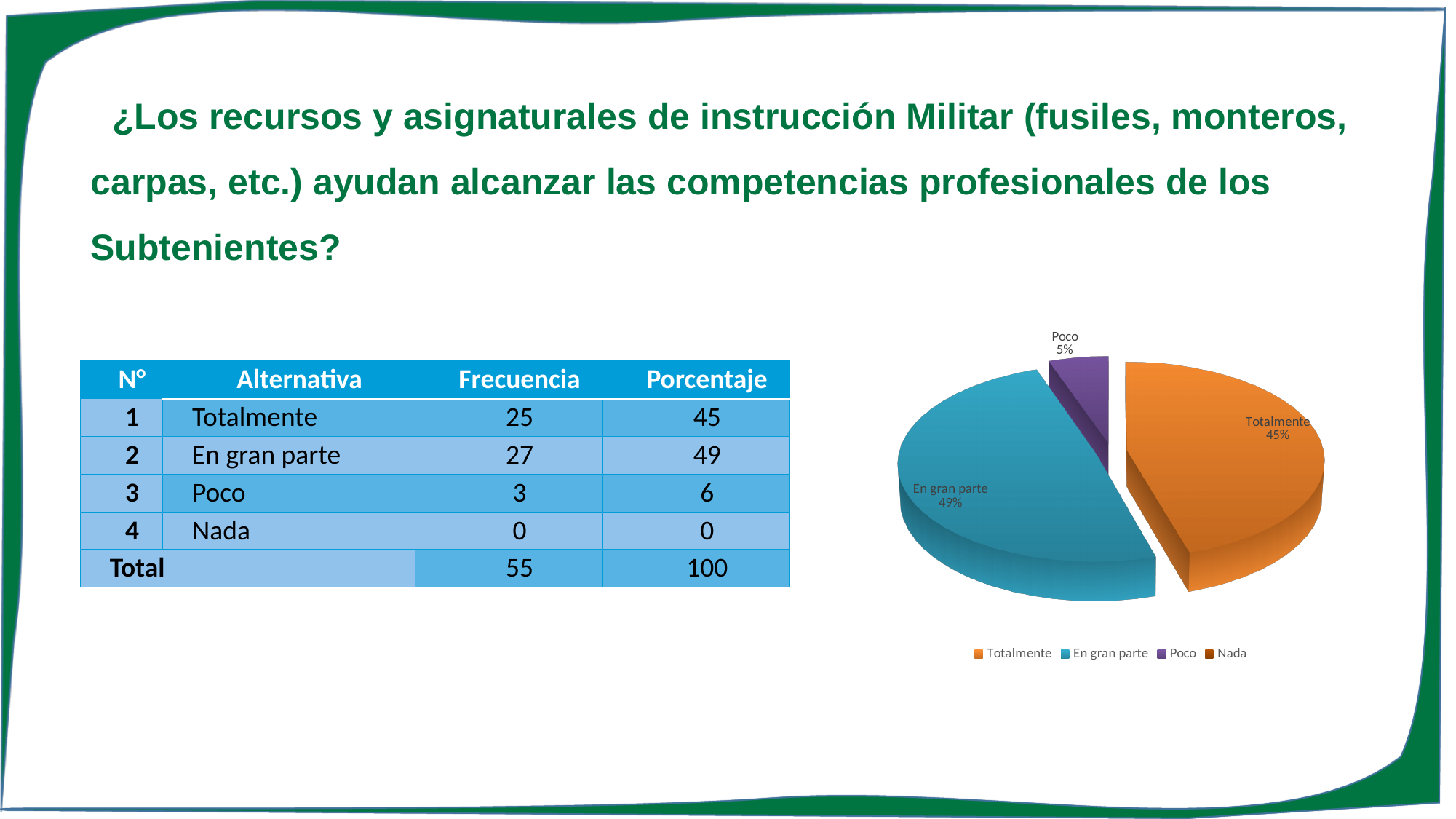
What percentage does the pie chart show for Poco? 5% Which category has the largest slice in the pie chart? En gran parte What is the difference in percentage points between the Totalmente and Poco slices? 40 What is the difference in percentage points between the En gran parte and Totalmente slices? 4 Which labelled slice in the pie chart is the smallest? Poco Which slice is larger in the pie chart, Totalmente or En gran parte? En gran parte What colour is the Totalmente slice in the pie chart? orange What percentage does the pie chart show for En gran parte? 49% What percentage does the pie chart show for Totalmente? 45% Which legend entry of the pie chart has no visible slice? Nada What kind of chart is shown on the slide? pie chart How many entries does the pie chart's legend list? 4